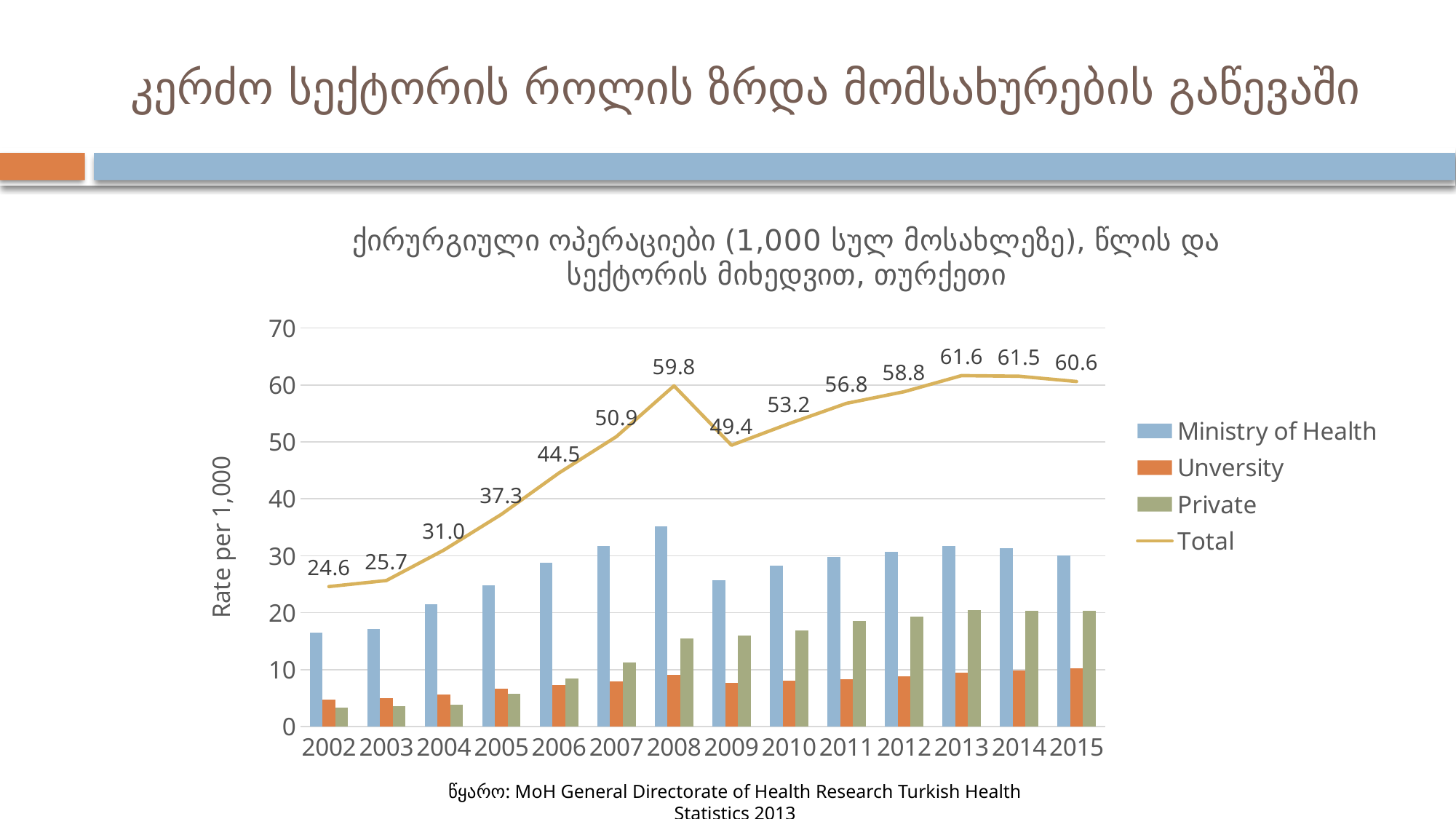
How many years are shown on the x axis? 14 What is the Total value for 2002? 24.6 Is the Private value for 2002 greater or less than 10? less Is the Total value for 2008 larger than the Total value for 2009? Yes What is the Total value for 2008? 59.8 What is the Total value for 2015? 60.6 In which year is the Total value lowest? 2002 What is the difference between the Total values for 2008 and 2009? 10.4 In which year is the Total value highest? 2013 Does the Total value rise or fall from 2002 to 2008? rise Is the Ministry of Health value for 2008 greater or less than 30? greater How many series does the legend list? 4